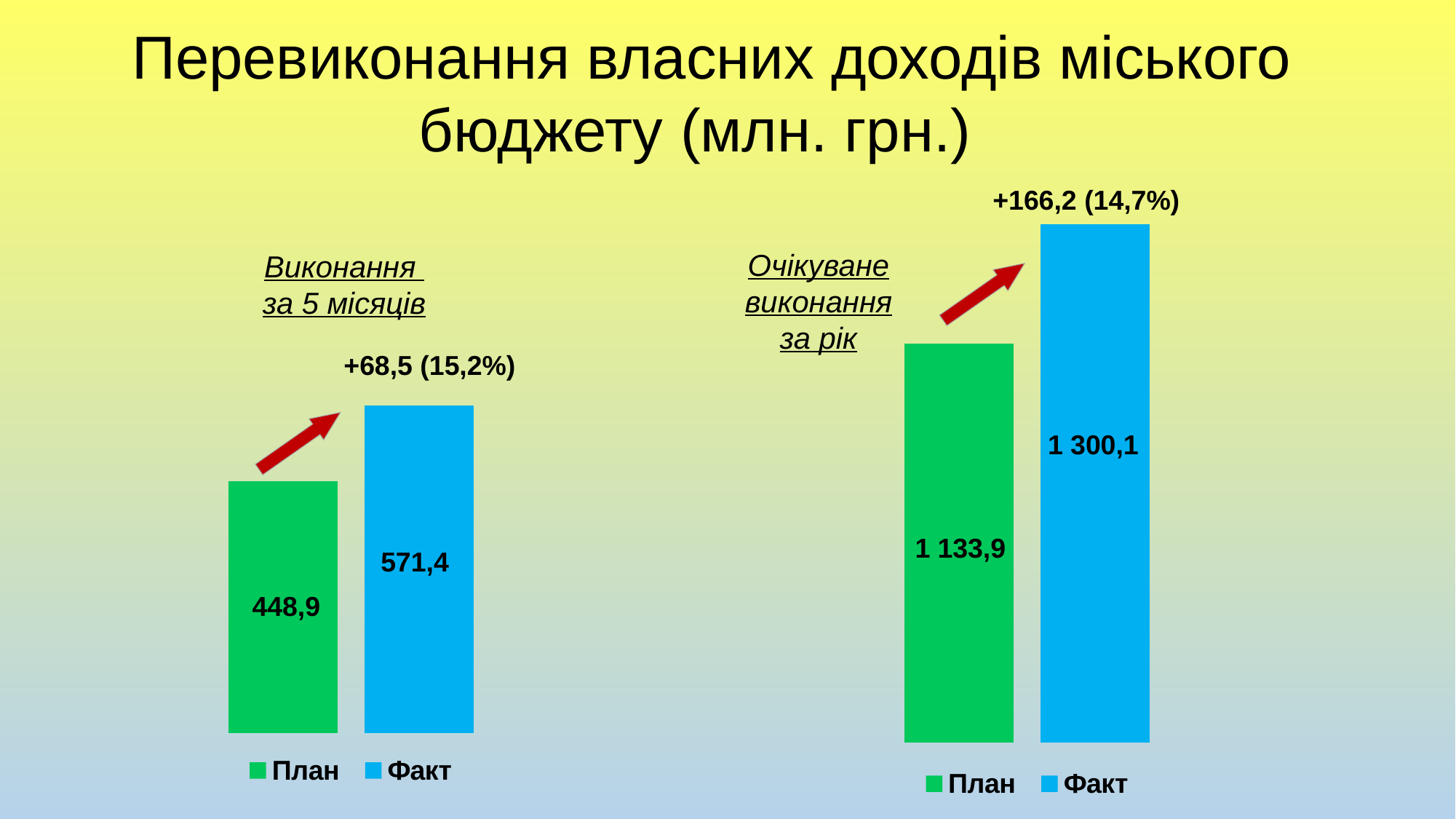
In the right chart (Очікуване виконання за рік), what is the difference between Факт and План? 166,2 In the left chart (Виконання за 5 місяців), what is the value for Факт? 571,4 In the right chart (Очікуване виконання за рік), which bar is the lowest? План What kind of chart is the left chart (Виконання за 5 місяців)? bar chart In the right chart (Очікуване виконання за рік), what is the value for План? 1 133,9 How many series does the legend of the right chart (Очікуване виконання за рік) list? 2 In the left chart (Виконання за 5 місяців), what is the value for План? 448,9 In the left chart (Виконання за 5 місяців), what is the difference between Факт and План? 122,5 In the left chart (Виконання за 5 місяців), what percentage is shown next to +68,5? 15,2% In the right chart (Очікуване виконання за рік), what colour is the Факт bar? blue In the left chart (Виконання за 5 місяців), which is larger, План or Факт? Факт In the right chart (Очікуване виконання за рік), what is the value for Факт? 1 300,1